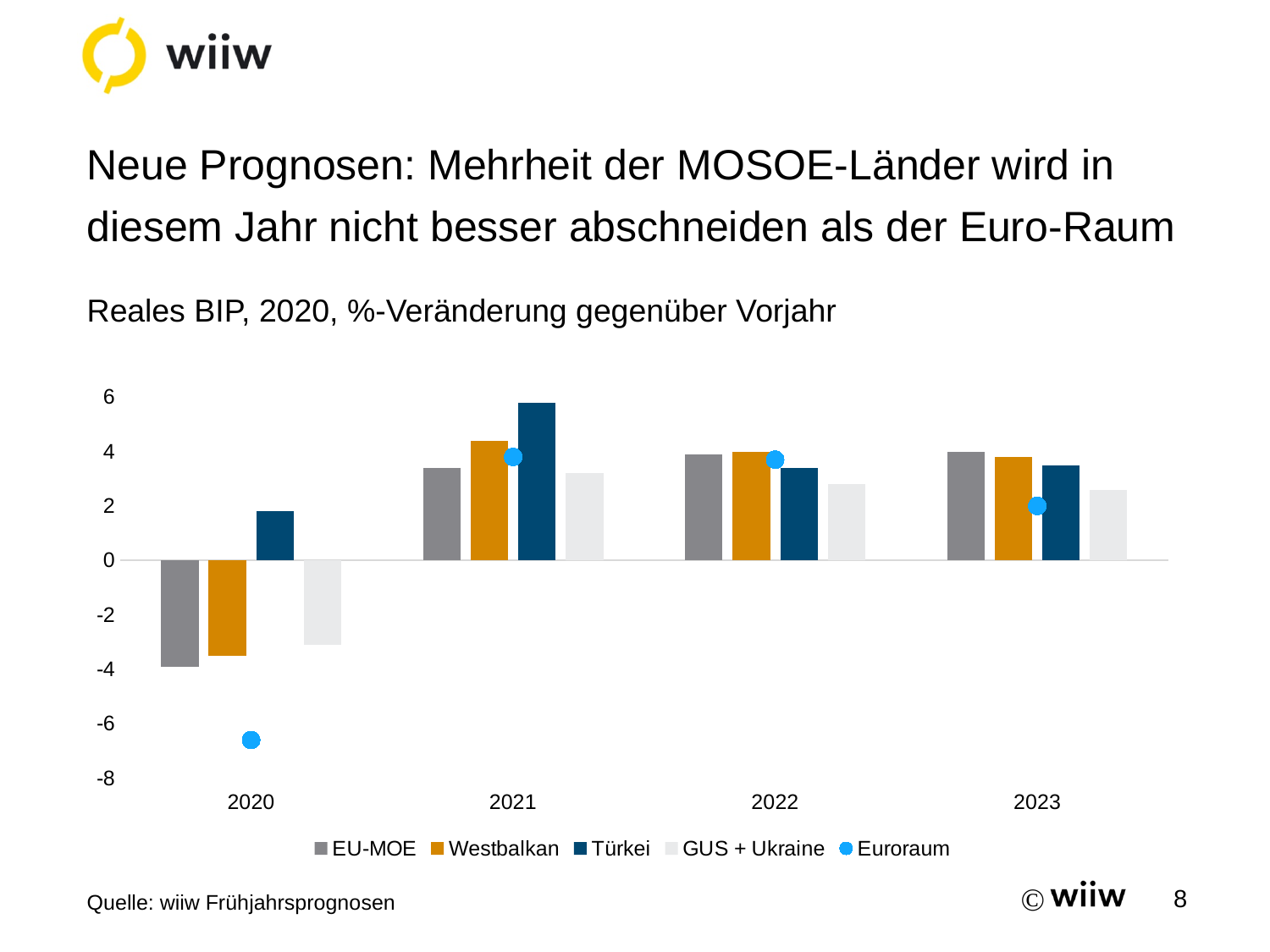
How many series does the legend list? 5 In 2023, which is larger: the value for Türkei or the value for Euroraum? Türkei Is the value for Türkei in 2021 greater or less than 4? greater In 2020, which is larger: the value for Türkei or the value for EU-MOE? Türkei What kind of chart is shown on the slide? combination bar and point chart (bars with Euroraum plotted as points) Which series is plotted as points rather than bars? Euroraum How many years are shown on the x axis? 4 Which series has the highest value in 2021? Türkei Is the value for Euroraum in 2020 greater or less than -6? less Does the value for Euroraum rise or fall from 2020 to 2021? rise Which series is the only one with a positive value in 2020? Türkei Which series has the lowest value in 2020? Euroraum